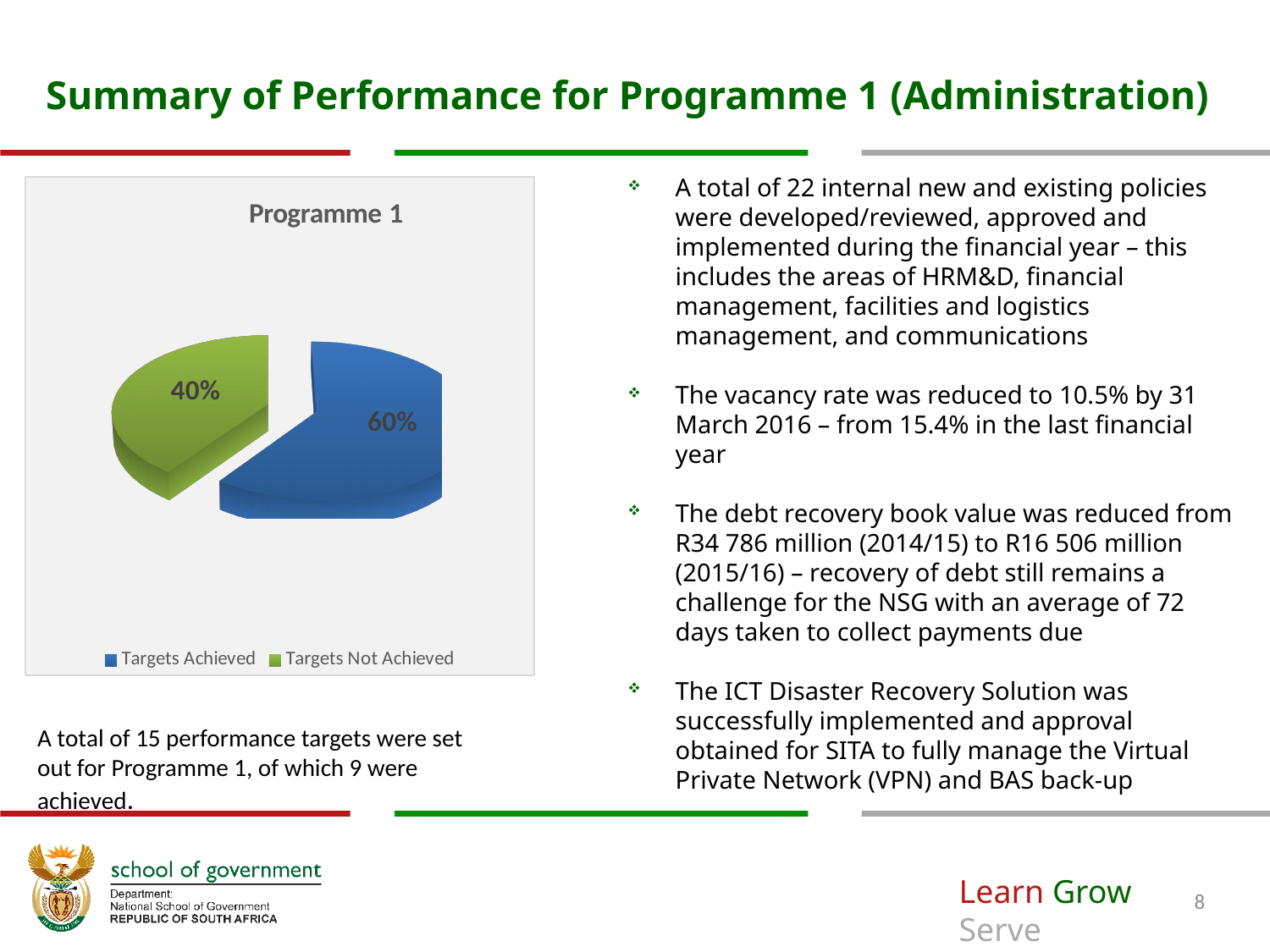
Which slice of the pie is the smallest? Targets Not Achieved What is the difference in percentage points between Targets Achieved and Targets Not Achieved? 20 How many entries does the legend list? 2 How many slices does the pie chart have? 2 What percentage of the pie is labelled Targets Achieved? 60% What percentage of the pie is labelled Targets Not Achieved? 40% Which is larger, the Targets Achieved slice or the Targets Not Achieved slice? Targets Achieved What is the title of the chart? Programme 1 Which slice of the pie is the largest? Targets Achieved What colour is the Targets Not Achieved slice? green What type of chart is shown on the slide? pie chart What share of the pie does the Targets Achieved slice represent? 60%